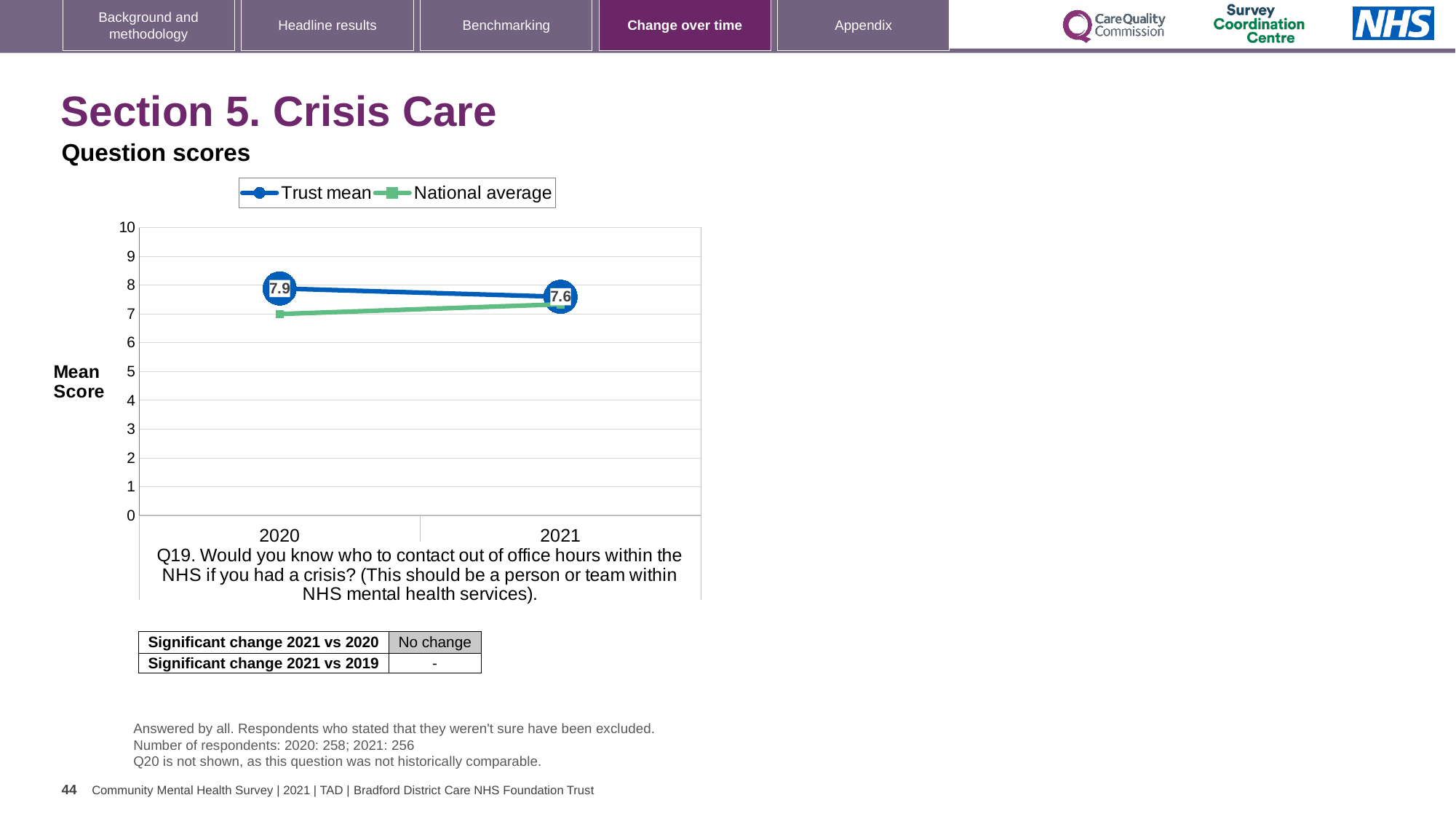
Which year has the higher Trust mean score, 2020 or 2021? 2020 Is the National average for 2020 greater or less than 8? less What is the Trust mean score for 2021? 7.6 In 2020, which is higher, the Trust mean or the National average? Trust mean How many series does the legend list? 2 What is the Trust mean score for 2020? 7.9 Does the National average rise or fall from 2020 to 2021? rise What kind of chart is shown on the slide? line chart Does the Trust mean rise or fall from 2020 to 2021? fall How many years are plotted on the x axis? 2 Is the National average for 2020 greater or less than 6? greater By how much did the Trust mean score change from 2020 to 2021? 0.3